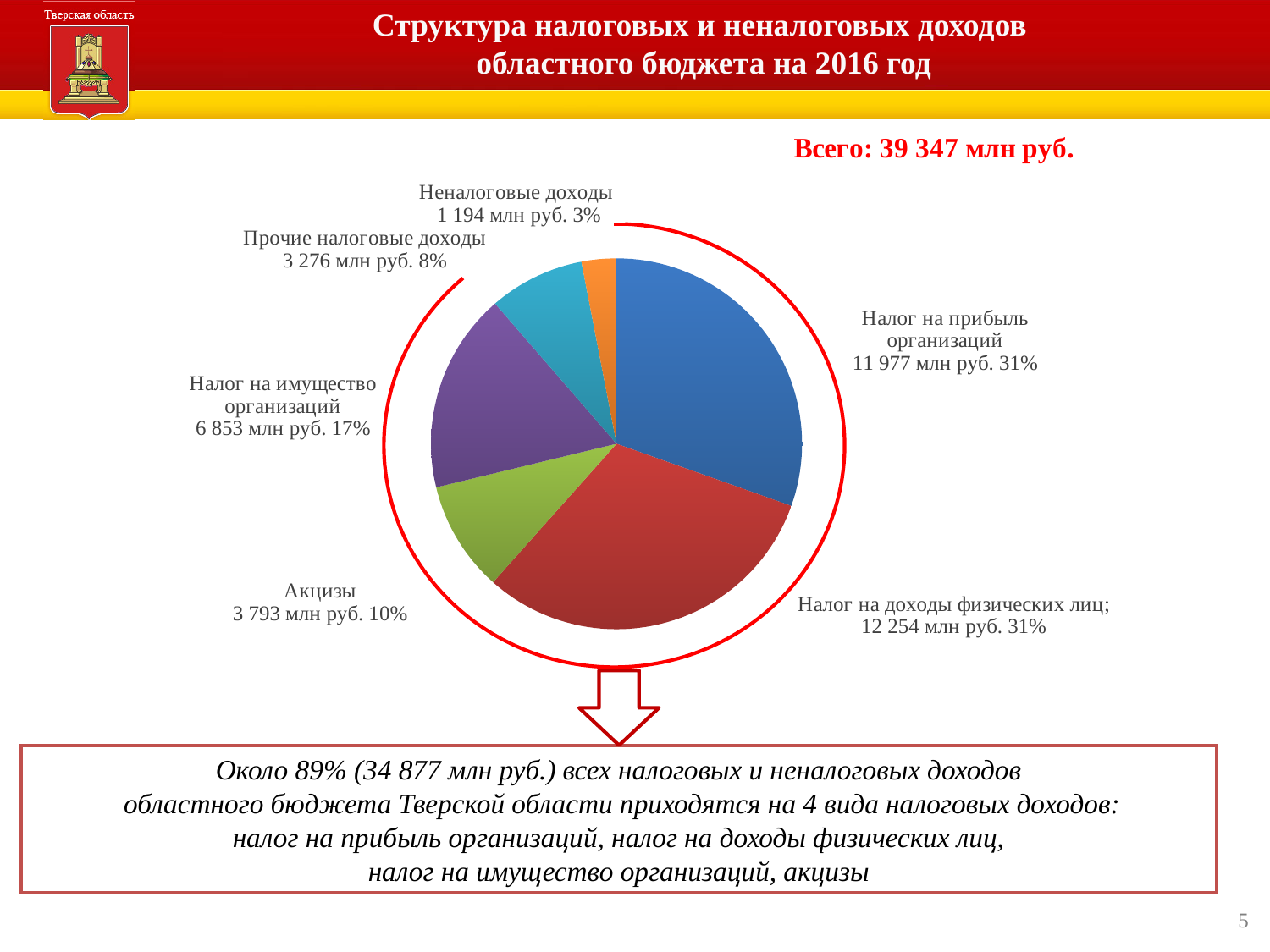
What is the difference between Налог на имущество организаций and Акцизы? 3 060 млн руб. What kind of chart is shown on the slide? Pie chart Which is larger, Прочие налоговые доходы or Акцизы? Акцизы What is the value for Акцизы? 3 793 млн руб. What share of the pie does Неналоговые доходы represent? 3% How many slices does the pie chart have? 6 What is the difference between Налог на доходы физических лиц and Налог на прибыль организаций? 277 млн руб. What is the value for Налог на прибыль организаций? 11 977 млн руб. What share of the pie does Налог на имущество организаций represent? 17% What total amount is stated above the pie chart? 39 347 млн руб. Which category has the smallest value in the pie chart? Неналоговые доходы Which category has the largest value in the pie chart? Налог на доходы физических лиц